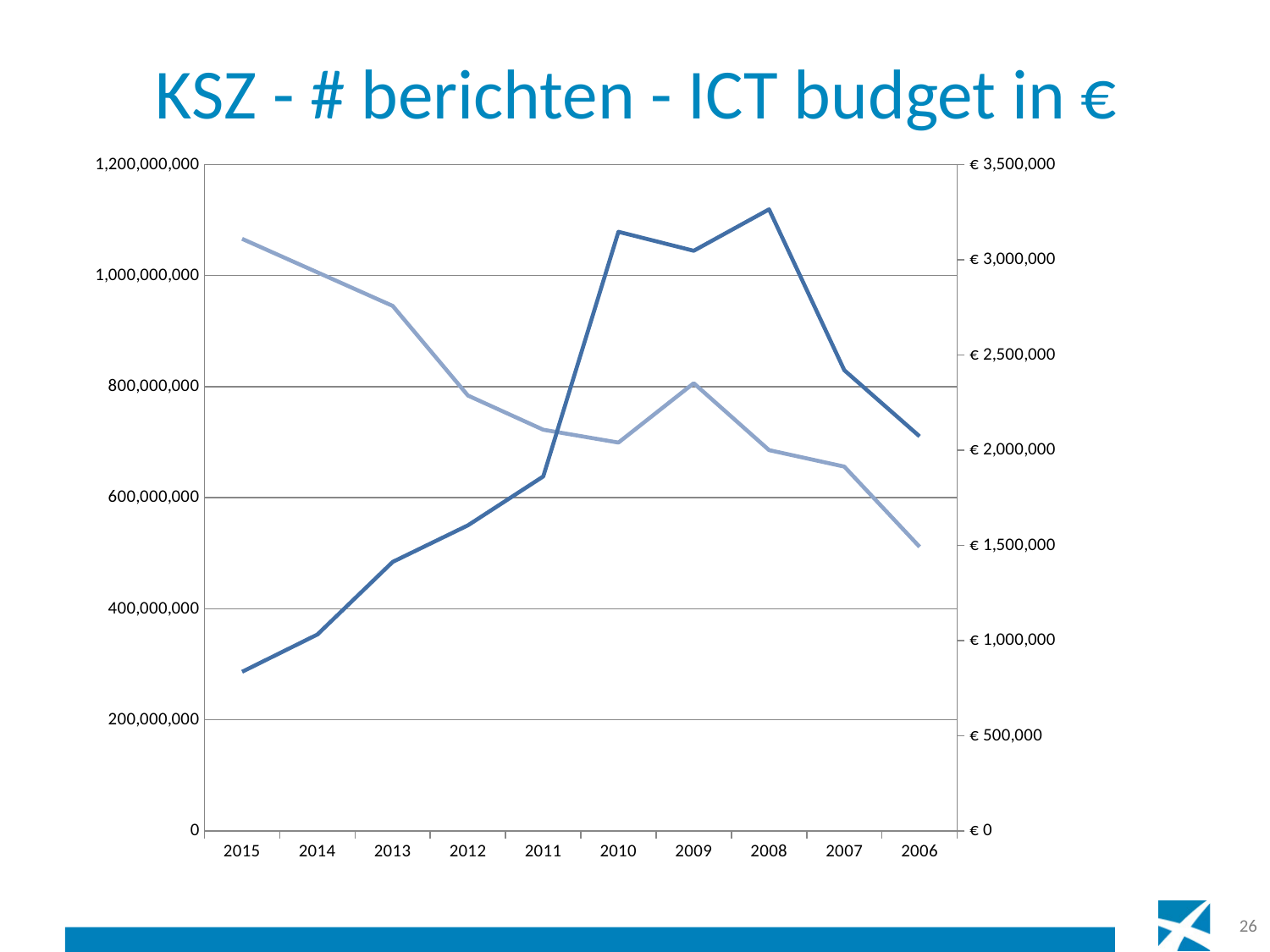
Is the dark blue line higher in 2010 or in 2007? 2010 What kind of chart is shown on the slide? line chart In which year does the dark blue line reach its highest point? 2008 What is the title of the chart? KSZ - # berichten - ICT budget in € In which year is the light blue line at its lowest point? 2006 Reading against the left axis, is the dark blue line's value for 2015 greater or less than 400,000,000? less Does the dark blue line rise or fall from 2015 to 2010 along the x axis? rise In which year is the light blue line at its highest point? 2015 In which year is the dark blue line at its lowest point? 2015 How many lines are plotted on the chart? 2 Does the light blue line rise or fall from 2015 to 2012 along the x axis? fall How many years are shown on the x axis? 10